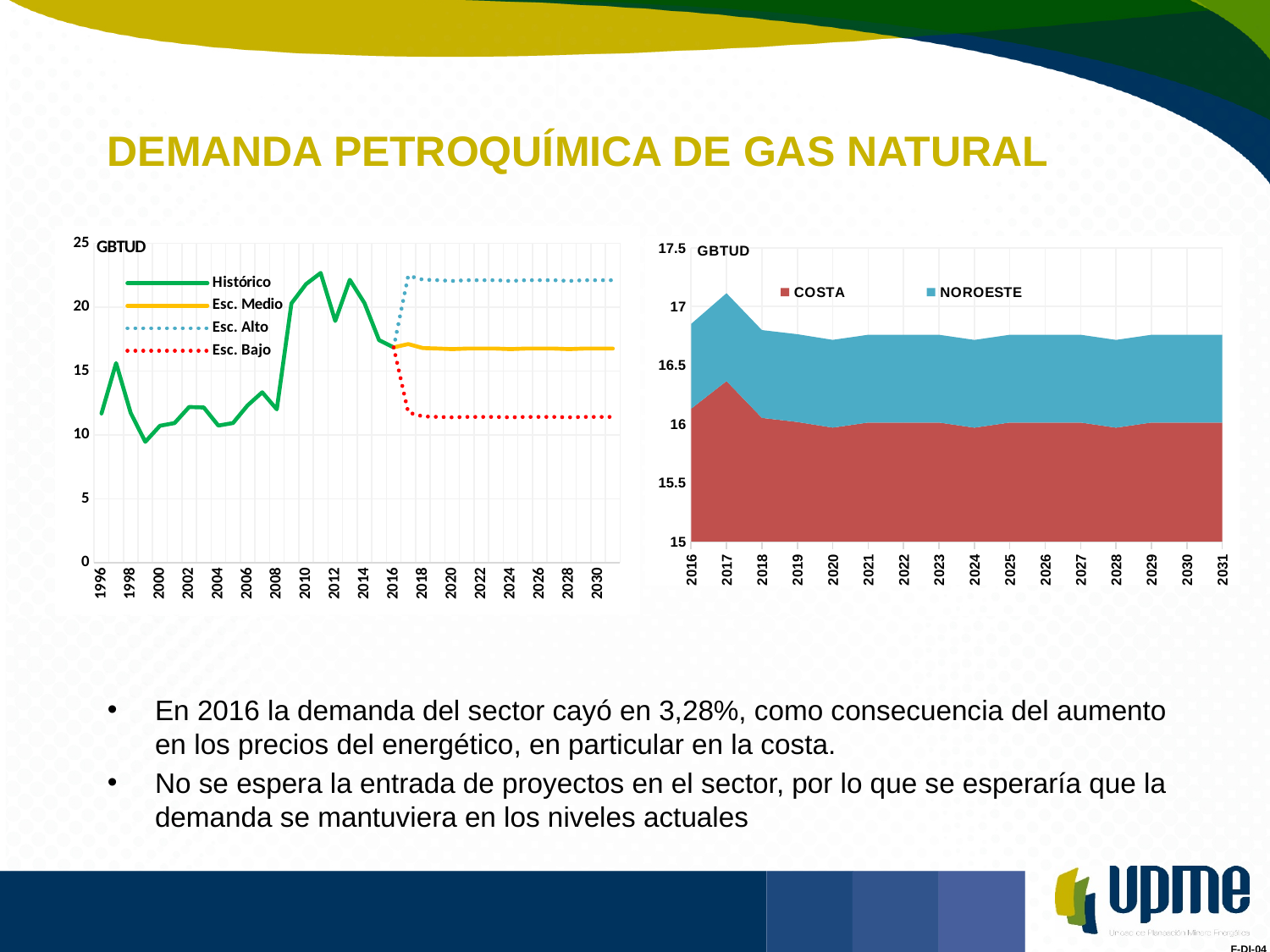
How many series does the legend of the left chart list? 4 In the left chart, is the value of Esc. Alto in 2025 greater or less than 20? greater In the right chart, is the COSTA value in 2020 greater or less than 16.5? less In the left chart, which series has the larger value in 2025, Esc. Alto or Esc. Bajo? Esc. Alto What kind of chart is the left chart on the slide? line chart In the left chart, is the value of Esc. Bajo in 2025 greater or less than 15? less How many series does the legend of the right chart list? 2 What unit label is shown at the top of both charts? GBTUD How many years are shown on the x axis of the right chart? 16 What kind of chart is the right chart on the slide? stacked area chart